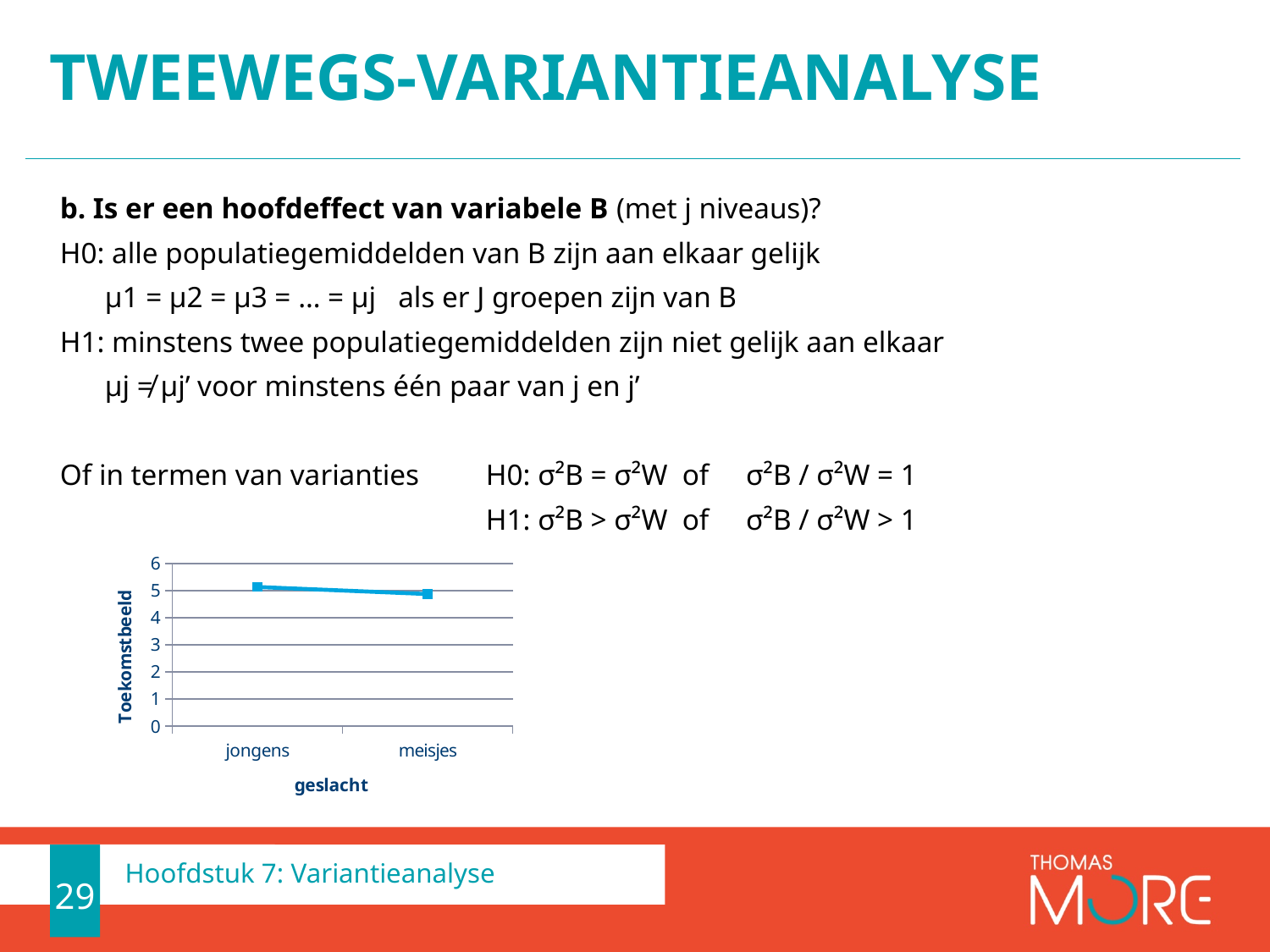
What kind of chart is shown on the slide? line chart How many categories are shown on the x axis of the chart? 2 Do the values rise or fall from jongens to meisjes in the chart? fall Is the value for meisjes greater or less than 4? greater Is the value for meisjes greater or less than 6? less What is the title of the vertical axis of the chart? Toekomstbeeld What is the title of the horizontal axis of the chart? geslacht Is the value for jongens greater or less than 4? greater Which category has the higher value in the chart, jongens or meisjes? jongens Which category has the highest value in the chart? jongens Which category has the lowest value in the chart? meisjes